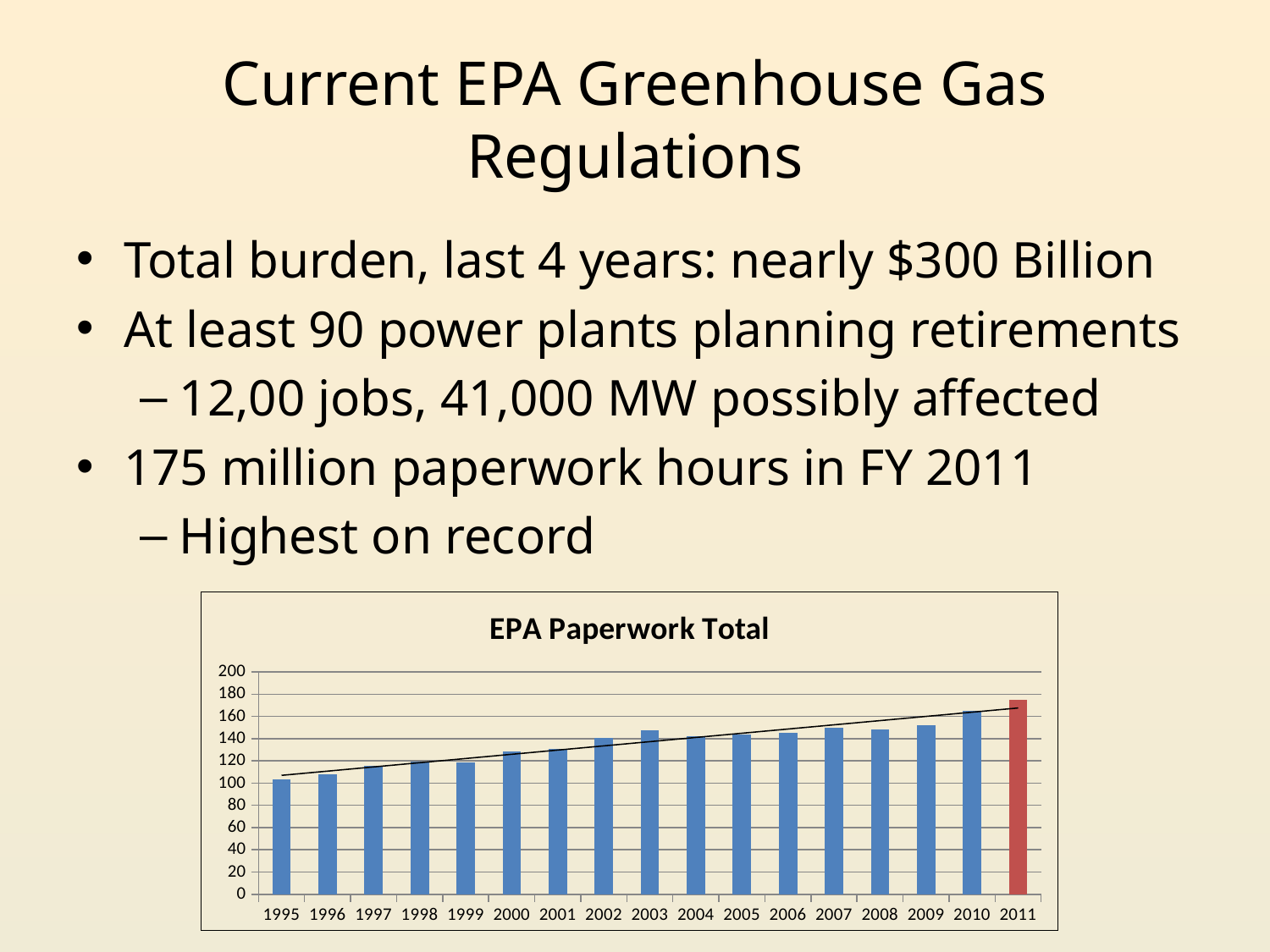
Do the values generally rise or fall from 1995 to 2011? rise How many years are shown on the x axis of the chart? 17 What is the title of the chart? EPA Paperwork Total Is the value for 2006 greater or less than 160? less Is the value for 2011 greater or less than 160? greater Is the value for 1996 greater or less than 120? less Which year has the lowest bar in the chart? 1995 Which bar is shown in a different colour (red) from the others? 2011 Which year has the highest bar in the chart? 2011 Which is larger, the value for 2010 or the value for 2011? 2011 What kind of chart is shown on the slide? bar chart